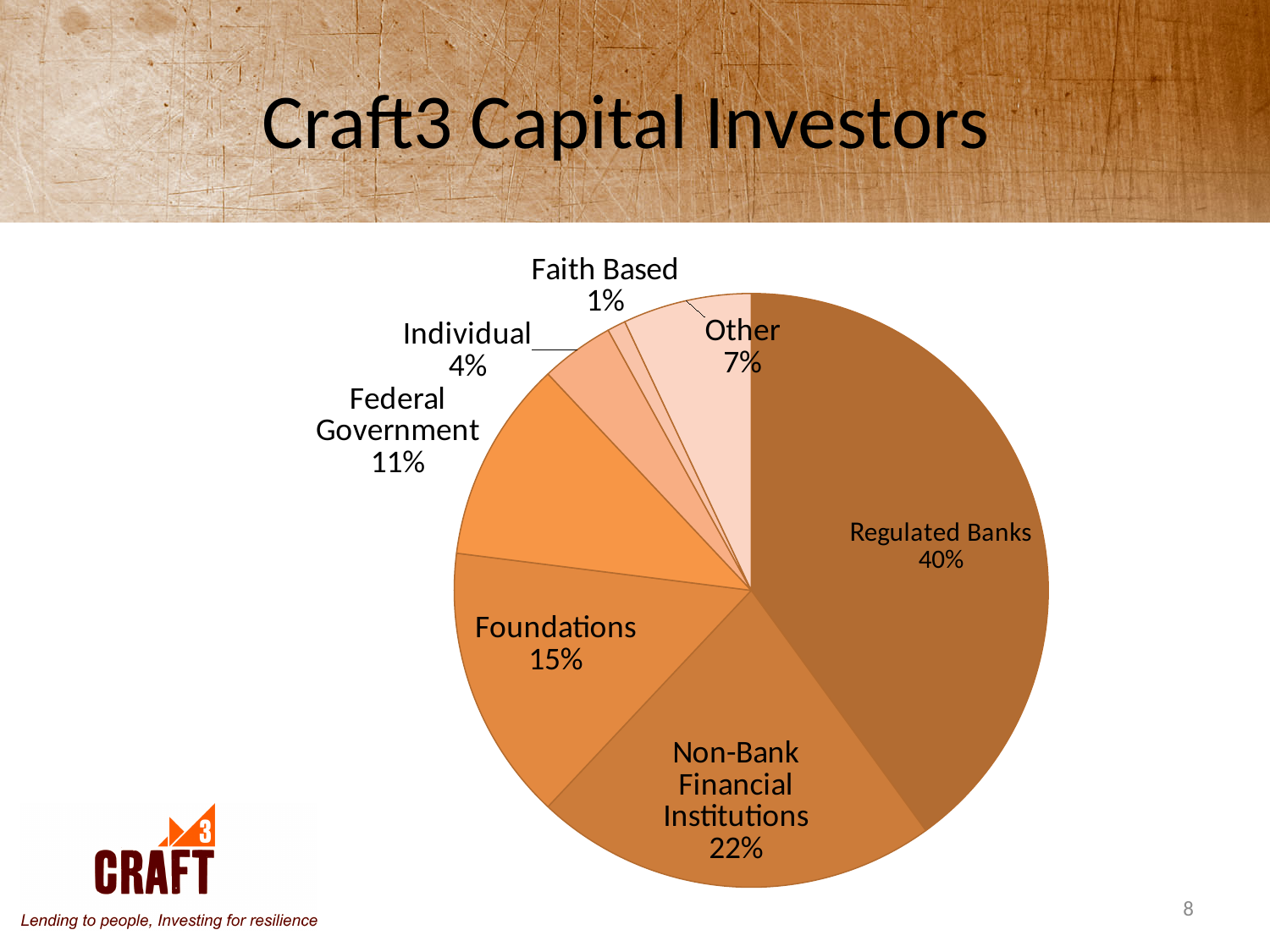
Which category has the largest slice of the pie? Regulated Banks Which category has the smallest slice of the pie? Faith Based What percentage is shown for Foundations? 15% What share of Craft3 capital investors is Regulated Banks? 40% Which is larger, the Other slice or the Individual slice? Other How many categories are shown in the pie chart? 7 What kind of chart is shown on the slide? Pie chart What percentage is shown for Federal Government? 11% What percentage is shown for Faith Based? 1% What percentage of the pie is Non-Bank Financial Institutions? 22% What is the difference in percentage points between Regulated Banks and Non-Bank Financial Institutions? 18 What is the title of the slide containing the chart? Craft3 Capital Investors